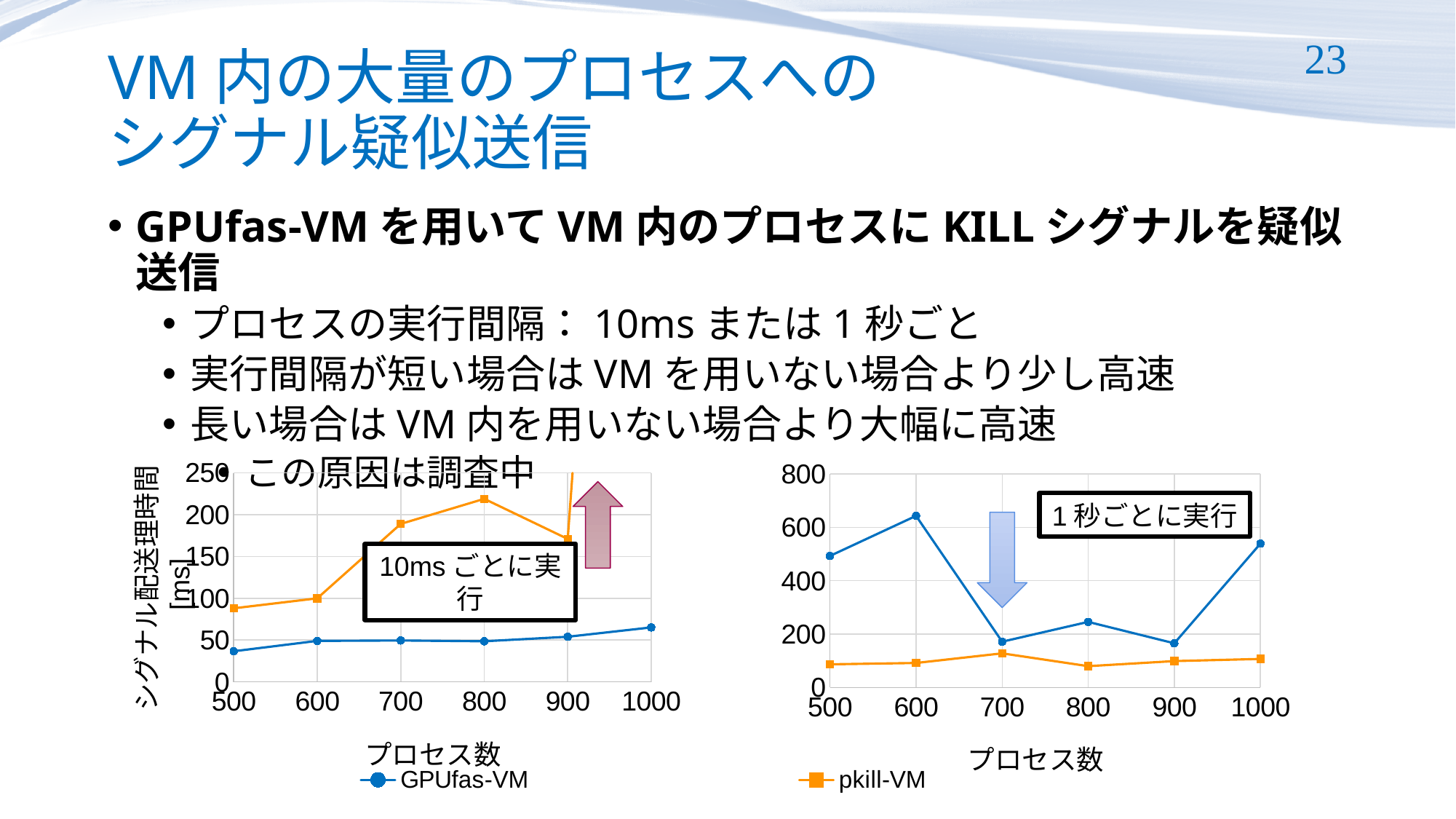
How many process-count points are plotted along the x axis of the right chart? 6 What kind of chart is the left chart on the slide? line chart What is the x-axis label of the right chart? プロセス数 In the right chart, is the value for pkill-VM at 700 processes greater or less than 200? less In the right chart, at 500 processes, which series has the larger value, GPUfas-VM or pkill-VM? GPUfas-VM In the left chart, at which process count does GPUfas-VM have its lowest value? 500 In the left chart, at 700 processes, which series has the larger value, GPUfas-VM or pkill-VM? pkill-VM In the right chart, at which process count does GPUfas-VM reach its highest value? 600 In the right chart, is the value for GPUfas-VM at 600 processes greater or less than 600? greater How many series does the legend list for the charts? 2 In the left chart, is the value for GPUfas-VM at 500 processes greater or less than 50? less